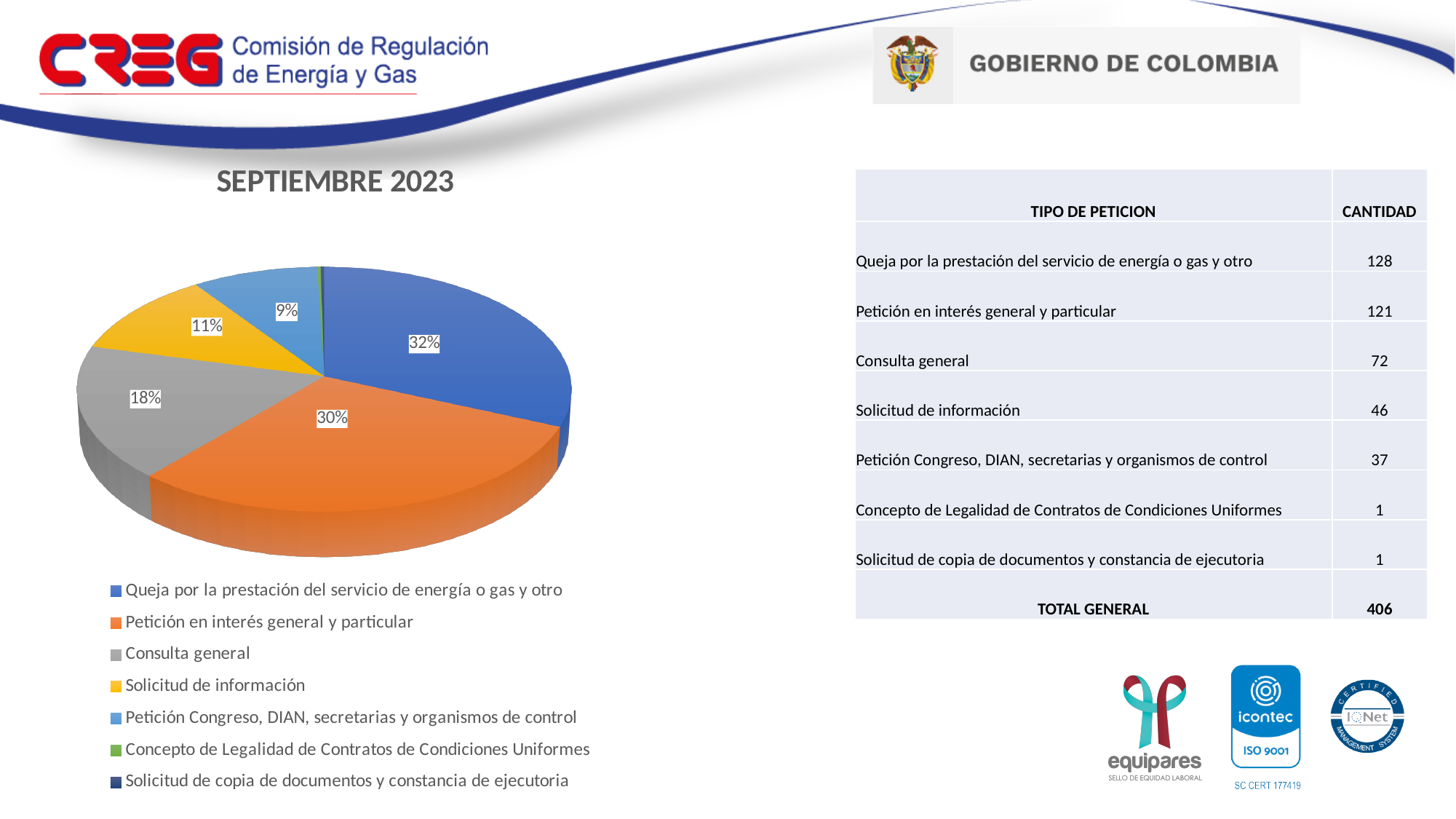
What is the title of the pie chart? SEPTIEMBRE 2023 What colour is the 'Petición en interés general y particular' slice in the pie chart? Orange What share of the pie does 'Petición en interés general y particular' represent? 30% What is the difference in percentage points between the 'Queja por la prestación del servicio de energía o gas y otro' slice and the 'Petición en interés general y particular' slice? 2 percentage points Which slice is larger: 'Consulta general' or 'Solicitud de información'? Consulta general What share of the pie does 'Solicitud de información' represent? 11% What share of the pie does 'Petición Congreso, DIAN, secretarias y organismos de control' represent? 9% Which category has the largest slice of the pie? Queja por la prestación del servicio de energía o gas y otro How many categories does the pie chart's legend list? 7 What kind of chart is shown on the slide? Pie chart